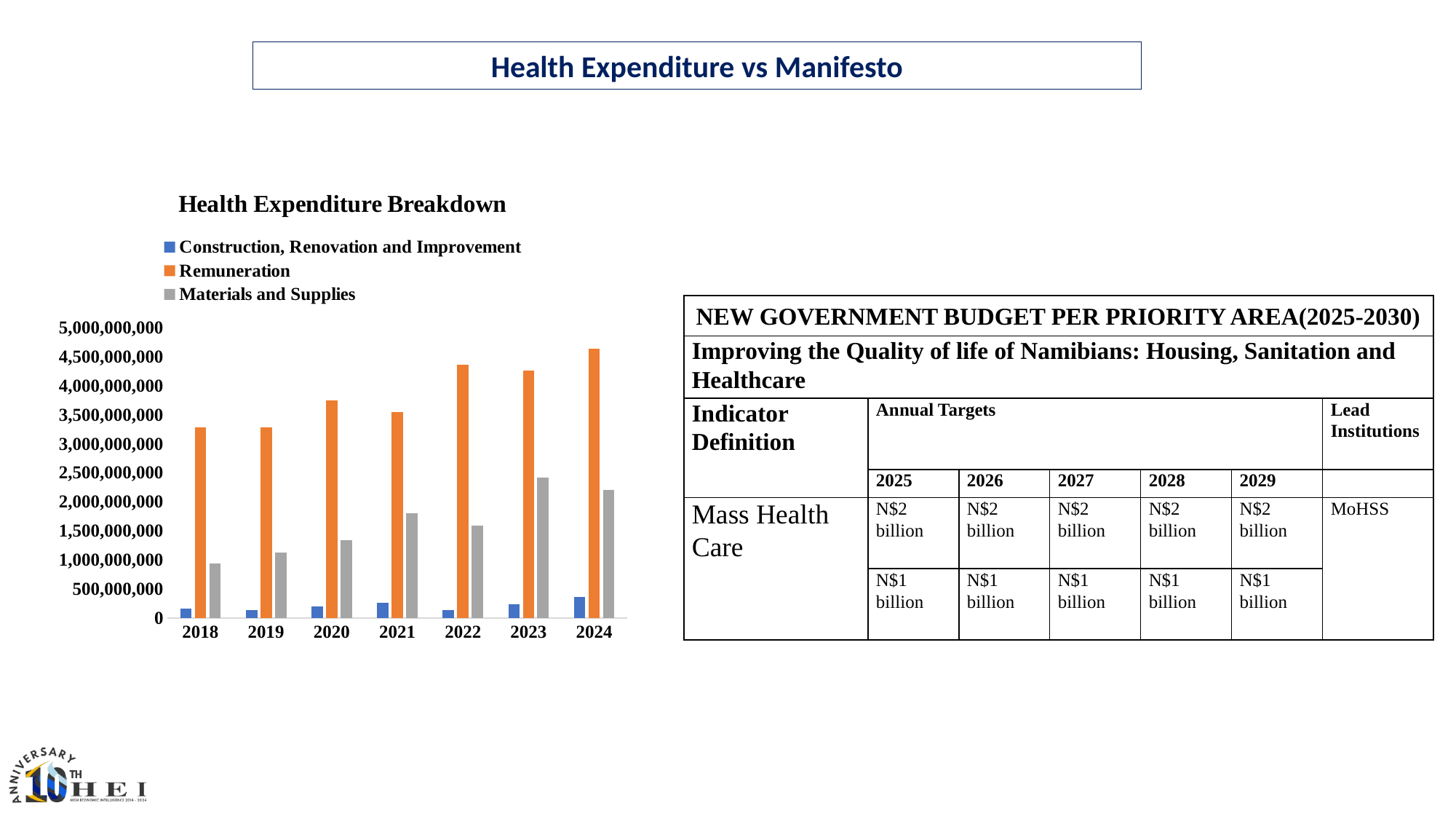
In the Health Expenditure Breakdown chart, is the Materials and Supplies value for 2023 greater or less than 2,000,000,000? greater In the Health Expenditure Breakdown chart, which year has the highest Remuneration value? 2024 In the Health Expenditure Breakdown chart, is the Remuneration value for 2024 greater or less than 4,000,000,000? greater In the Health Expenditure Breakdown chart, which year has the highest Materials and Supplies value? 2023 In the Health Expenditure Breakdown chart, which year has the lowest Materials and Supplies value? 2018 What kind of chart is the Health Expenditure Breakdown chart? bar chart In the Health Expenditure Breakdown chart, is the Remuneration value for 2018 greater or less than 3,000,000,000? greater In the Health Expenditure Breakdown chart, which colour represents Remuneration in the legend? orange How many years are shown on the x axis of the Health Expenditure Breakdown chart? 7 In the Health Expenditure Breakdown chart, which is larger in 2024: Remuneration or Materials and Supplies? Remuneration How many series does the legend of the Health Expenditure Breakdown chart list? 3